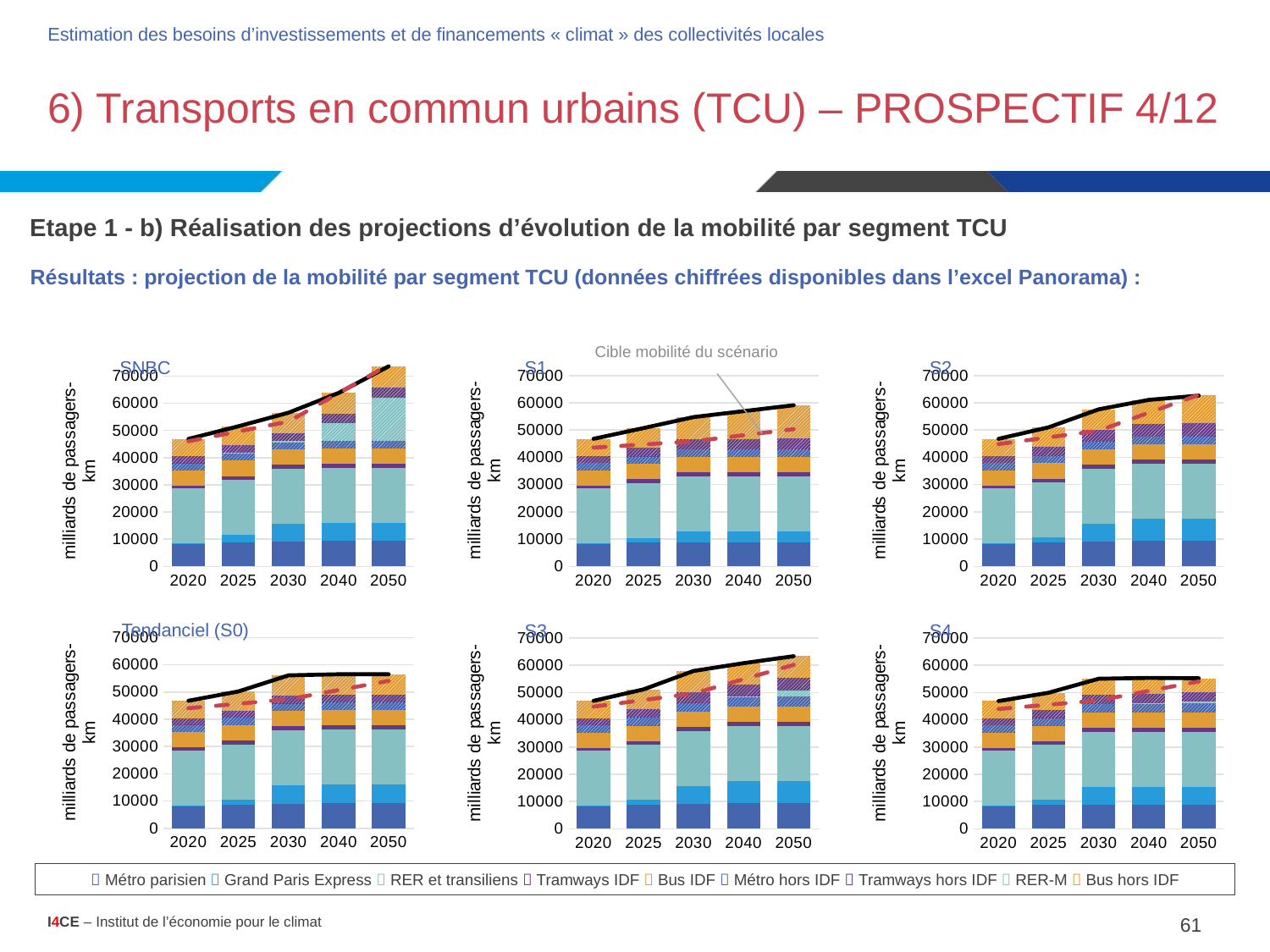
In the Tendanciel (S0) chart, is the total stacked value for 2030 greater or less than 50000? greater In the S2 chart, do the total stacked values rise or fall from 2020 to 2050? rise In the SNBC chart, is the total stacked value for 2020 greater or less than 50000? less How many charts are shown on the slide? 6 What is the y-axis label on the S1 chart? milliards de passagers-km What kind of chart is the SNBC chart on the slide? Combination stacked bar and line chart How many years are shown on the x axis of the S1 chart? 5 How many series does the shared legend at the bottom of the slide list? 9 What is the first series listed in the legend at the bottom of the slide? Métro parisien In the S3 chart, is the total stacked value for 2050 greater or less than 60000? greater